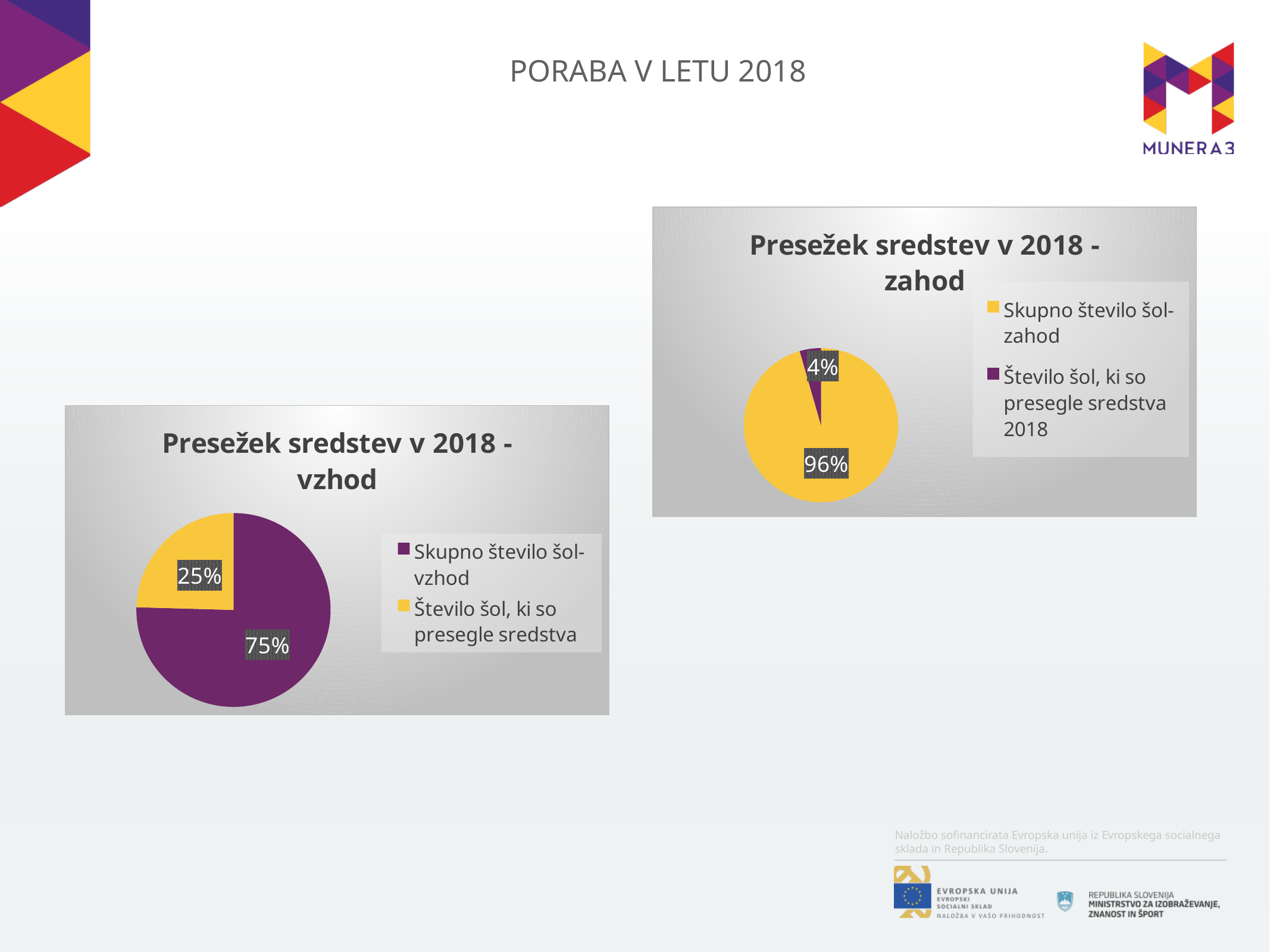
In the chart titled "Presežek sredstev v 2018 - zahod", what share of the pie is "Število šol, ki so presegle sredstva 2018"? 4% Which is larger: the "Število šol, ki so presegle sredstva" slice in the vzhod chart or the "Število šol, ki so presegle sredstva 2018" slice in the zahod chart? Število šol, ki so presegle sredstva (vzhod) In the chart titled "Presežek sredstev v 2018 - vzhod", what share of the pie is "Število šol, ki so presegle sredstva"? 25% In the chart titled "Presežek sredstev v 2018 - vzhod", what share of the pie is "Skupno število šol-vzhod"? 75% What type of chart is "Presežek sredstev v 2018 - zahod"? Pie chart In the chart titled "Presežek sredstev v 2018 - zahod", which slice is the smallest? Število šol, ki so presegle sredstva 2018 In the chart titled "Presežek sredstev v 2018 - vzhod", what is the difference in percentage points between the two slices? 50 In the chart titled "Presežek sredstev v 2018 - zahod", what colour is the "Skupno število šol-zahod" slice? Yellow How many slices does the chart titled "Presežek sredstev v 2018 - vzhod" have? 2 In the chart titled "Presežek sredstev v 2018 - vzhod", which slice is the largest? Skupno število šol-vzhod In the chart titled "Presežek sredstev v 2018 - zahod", what is the difference in percentage points between the two slices? 92